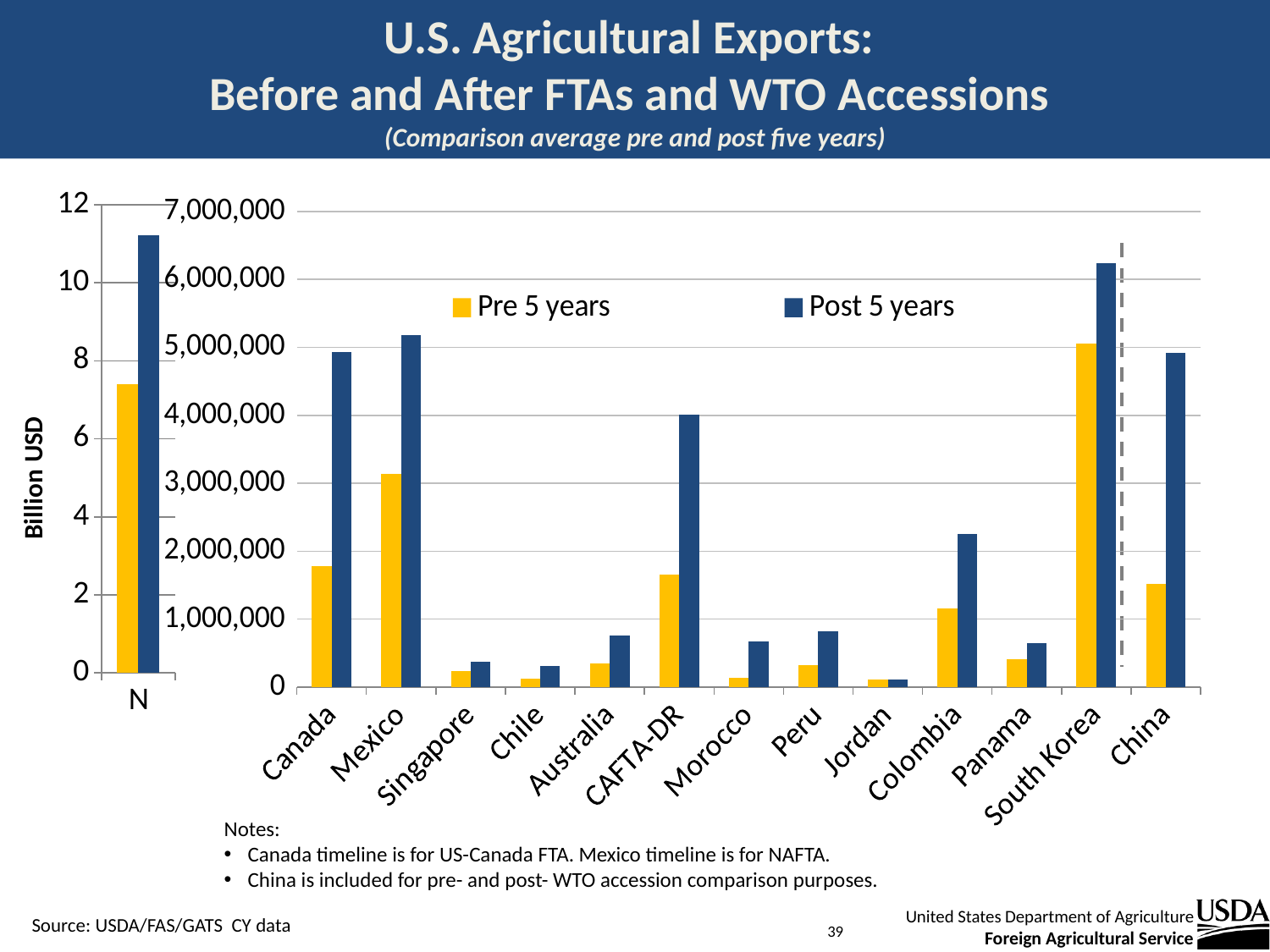
How many series does the legend of the large chart list? 2 How many countries or regions are shown on the x axis of the large chart? 13 In the large chart, is the Post 5 years value for Canada greater or less than 4,000,000? greater In the large chart, which is larger: the Pre 5 years value for Mexico or the Pre 5 years value for Canada? Mexico In the large chart, which category has the lowest Post 5 years value? Jordan What type of chart is the large chart on the right of the slide? bar chart In the small chart on the left, is the Post 5 years value for N greater or less than 10? greater In the large chart, is the Pre 5 years value for Canada greater or less than 2,000,000? less What are the two series named in the legend of the large chart? Pre 5 years and Post 5 years In the large chart, which category has the highest Post 5 years value? South Korea In the large chart, which category has the highest Pre 5 years value? South Korea